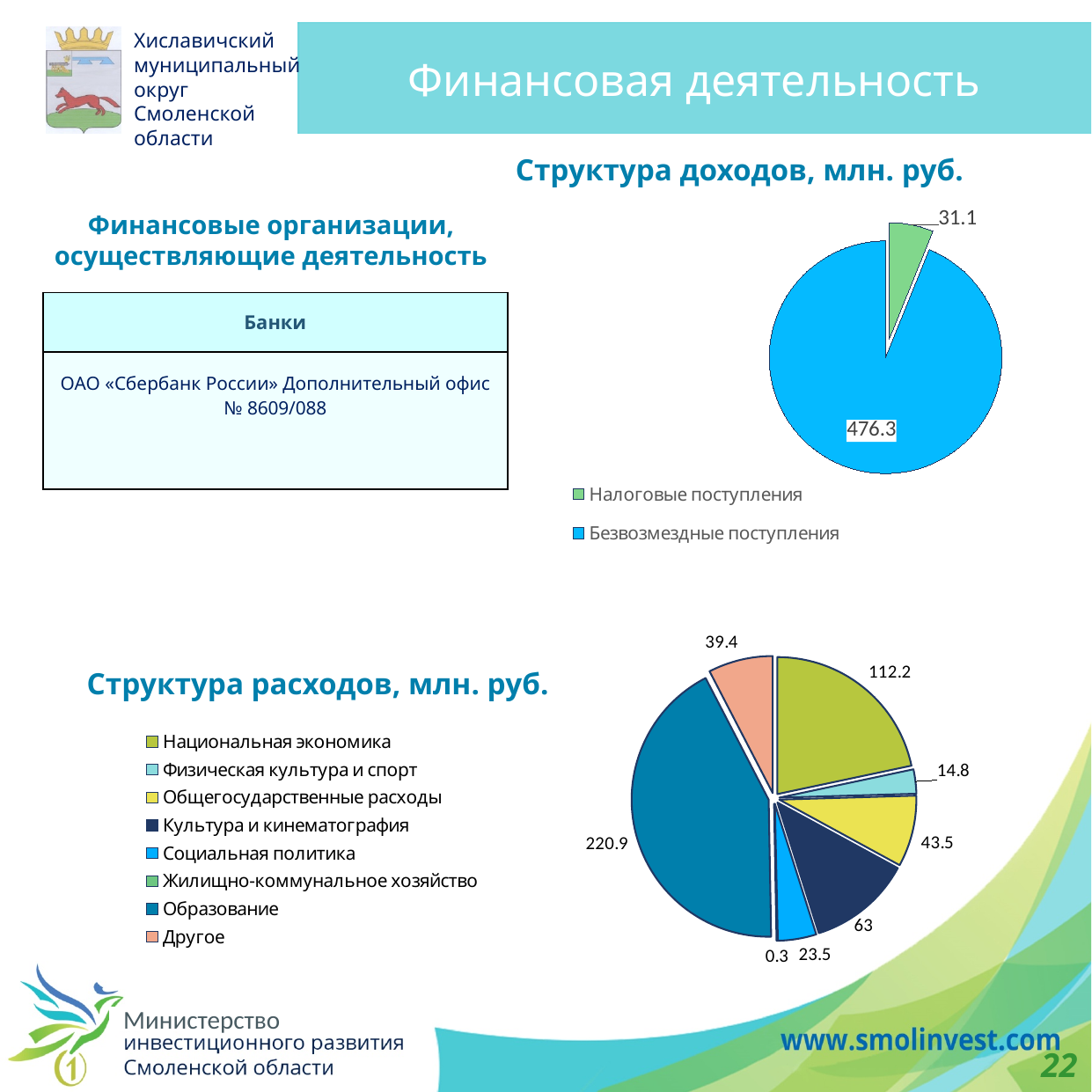
What kind of chart is the 'Структура доходов, млн. руб.' chart? pie chart In the 'Структура доходов, млн. руб.' chart, what is the value for Безвозмездные поступления? 476.3 In the 'Структура расходов, млн. руб.' chart, which category has the smallest value? Жилищно-коммунальное хозяйство In the 'Структура доходов, млн. руб.' chart, what is the difference between Безвозмездные поступления and Налоговые поступления? 445.2 How many entries does the legend of the 'Структура доходов, млн. руб.' chart list? 2 In the 'Структура доходов, млн. руб.' chart, what is the value for Налоговые поступления? 31.1 In the 'Структура расходов, млн. руб.' chart, which category has the largest value? Образование In the 'Структура расходов, млн. руб.' chart, what is the difference between Образование and Национальная экономика? 108.7 How many categories are shown in the 'Структура расходов, млн. руб.' chart? 8 In the 'Структура расходов, млн. руб.' chart, what is the value for Образование? 220.9 In the 'Структура расходов, млн. руб.' chart, which is larger: Культура и кинематография or Общегосударственные расходы? Культура и кинематография In the 'Структура расходов, млн. руб.' chart, what is the value for Национальная экономика? 112.2